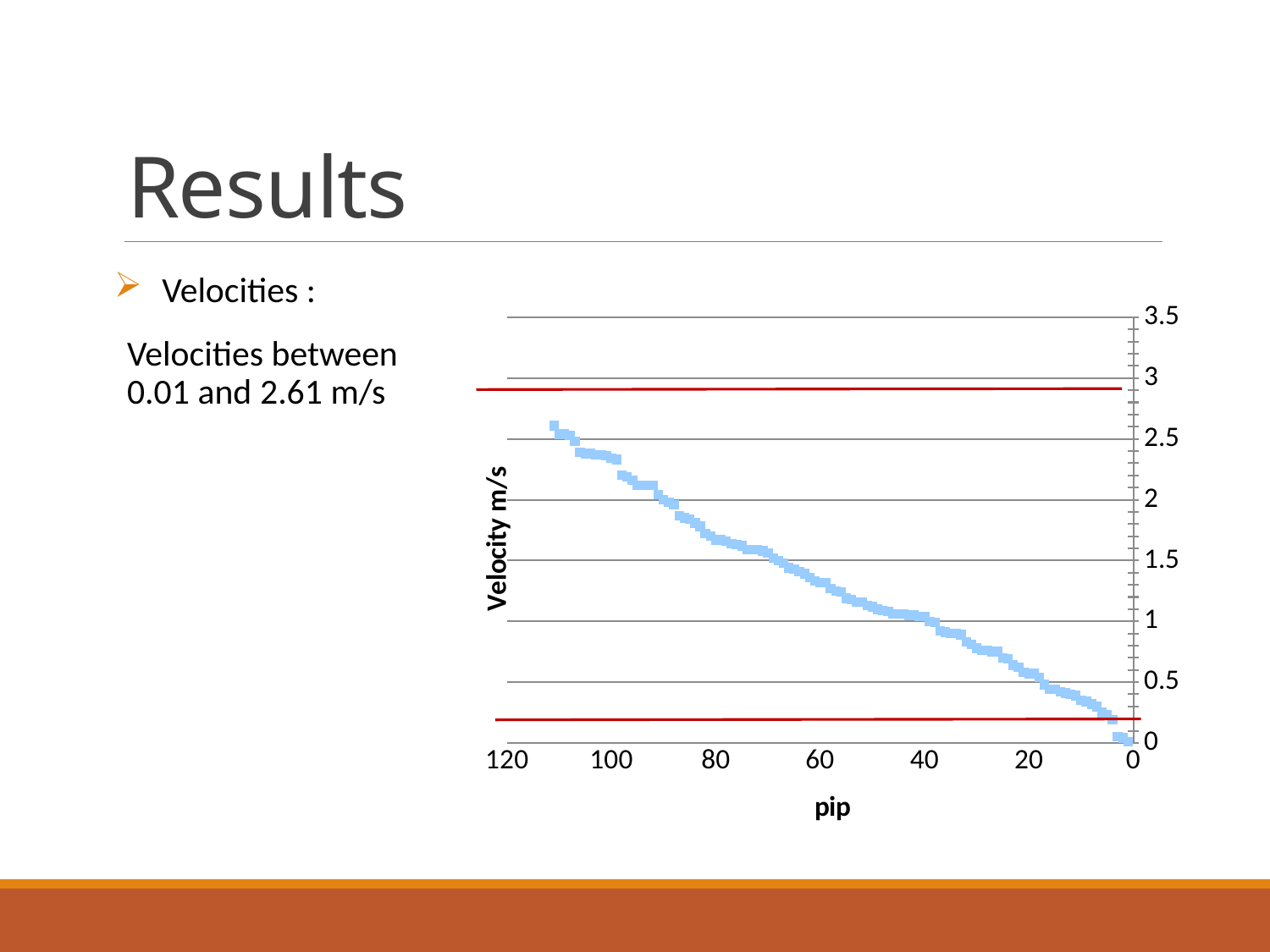
Is the plotted velocity at pip 100 greater or less than 2? greater Is the plotted velocity at pip 20 greater or less than 1? less What is the title of the vertical axis of the chart? Velocity m/s Is the plotted velocity at pip 40 greater or less than 0.5? greater What is the title of the horizontal axis of the chart? pip Which has the larger plotted velocity, pip 100 or pip 20? pip 100 What kind of chart is shown on the slide? scatter chart Moving left to right along the x axis, do the plotted velocity values rise or fall? fall